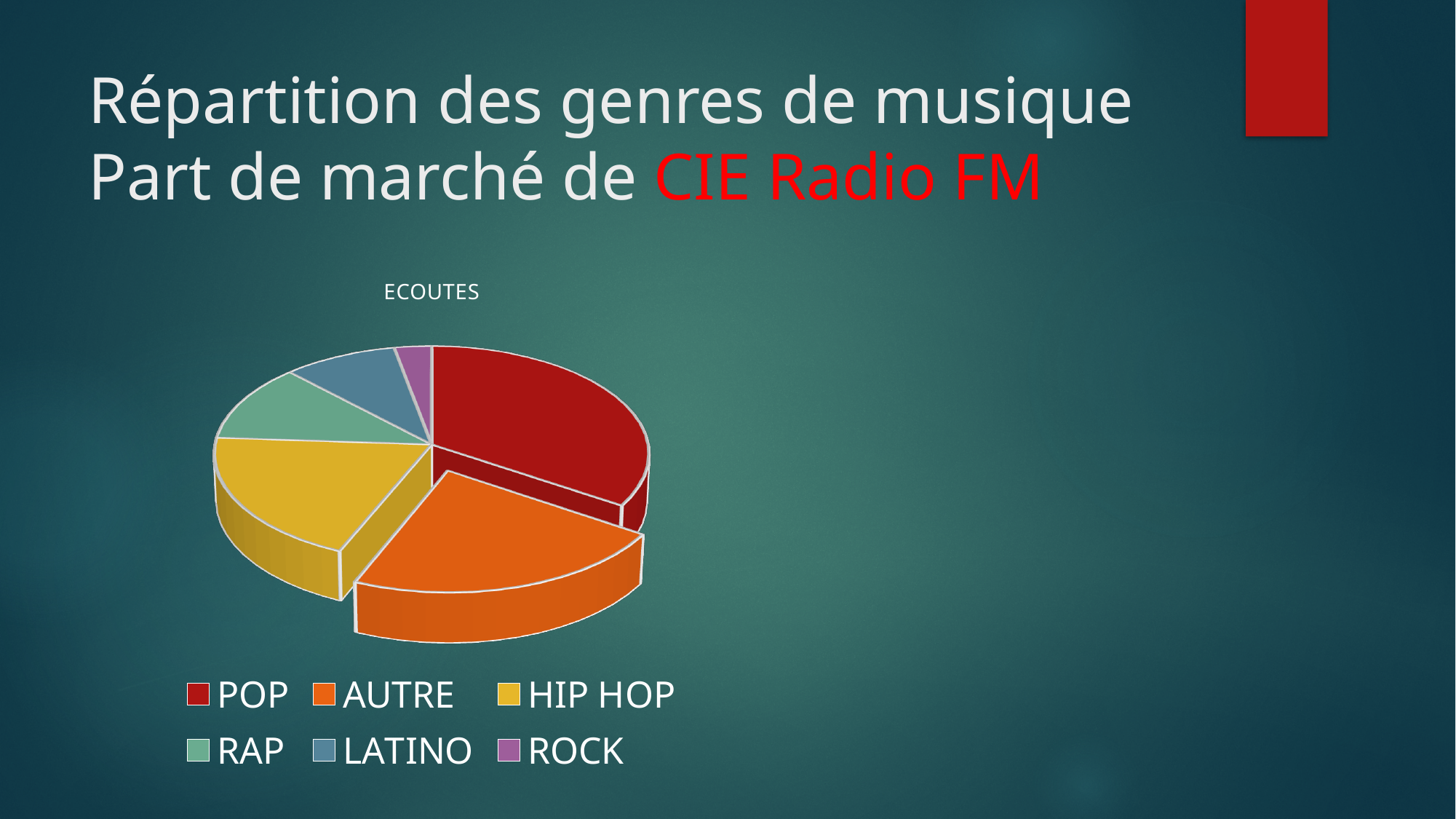
Which slice is larger, POP or ROCK? POP Which category has the smallest slice of the pie? ROCK Which slice is larger, AUTRE or LATINO? AUTRE How many categories does the pie chart have? 6 Which slice is larger, AUTRE or ROCK? AUTRE What is the title of the chart? ECOUTES Which category has the largest slice of the pie? POP What kind of chart is shown on the slide? pie chart Which category is shown in red in the pie chart? POP